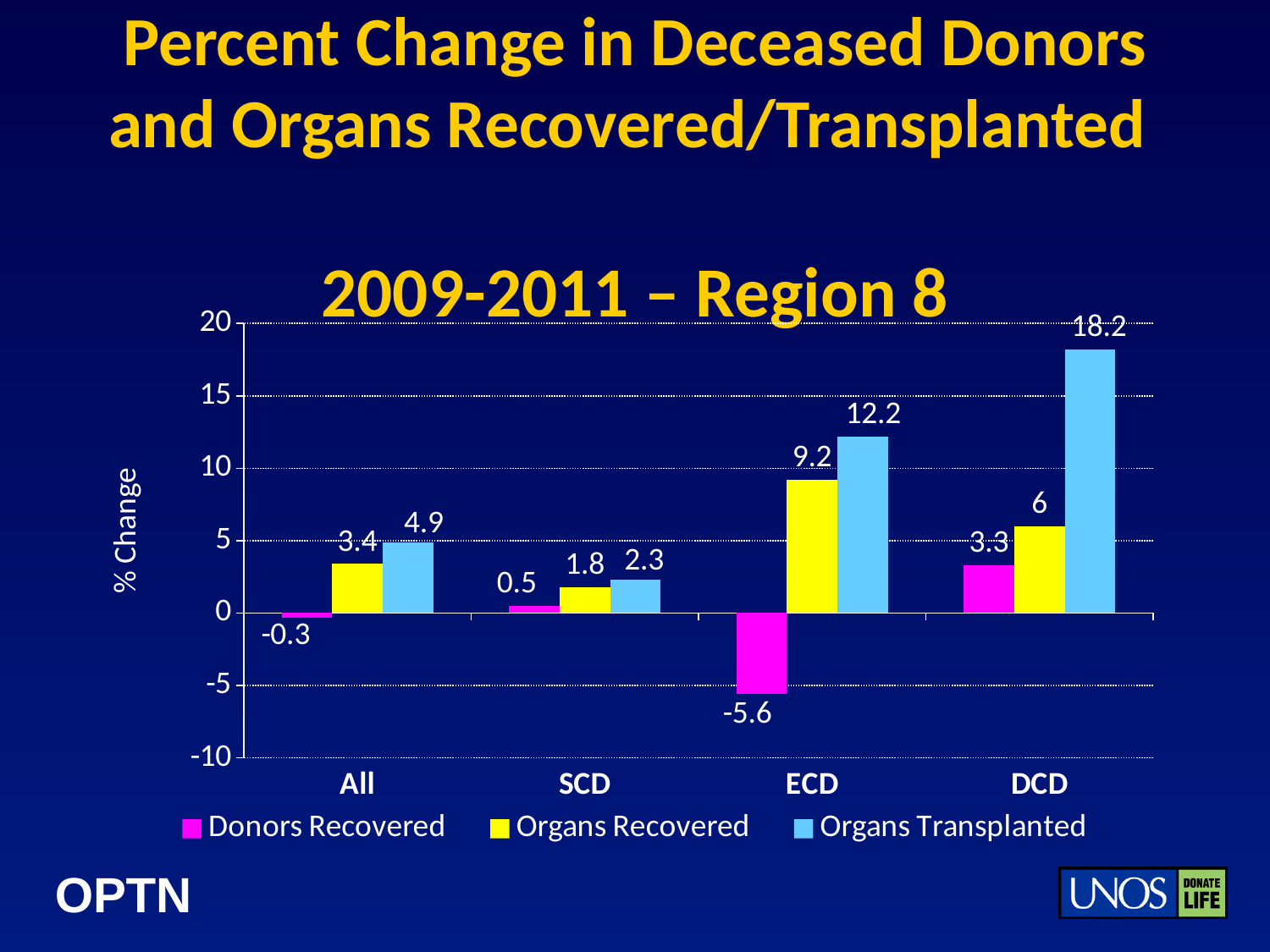
What is the percent change in Organs Recovered for SCD? 1.8 What is the percent change in Donors Recovered for ECD? -5.6 How many categories are shown on the x axis? 4 What is the percent change in Donors Recovered for All? -0.3 Which category has the lowest Donors Recovered value? ECD What is the percent change in Organs Transplanted for DCD? 18.2 Which category has the highest Organs Transplanted value? DCD What is the label of the y axis? % Change How many series does the legend list? 3 Which is larger for DCD: Donors Recovered or Organs Recovered? Organs Recovered What kind of chart is shown? bar chart What is the difference between Organs Transplanted and Organs Recovered for ECD? 3